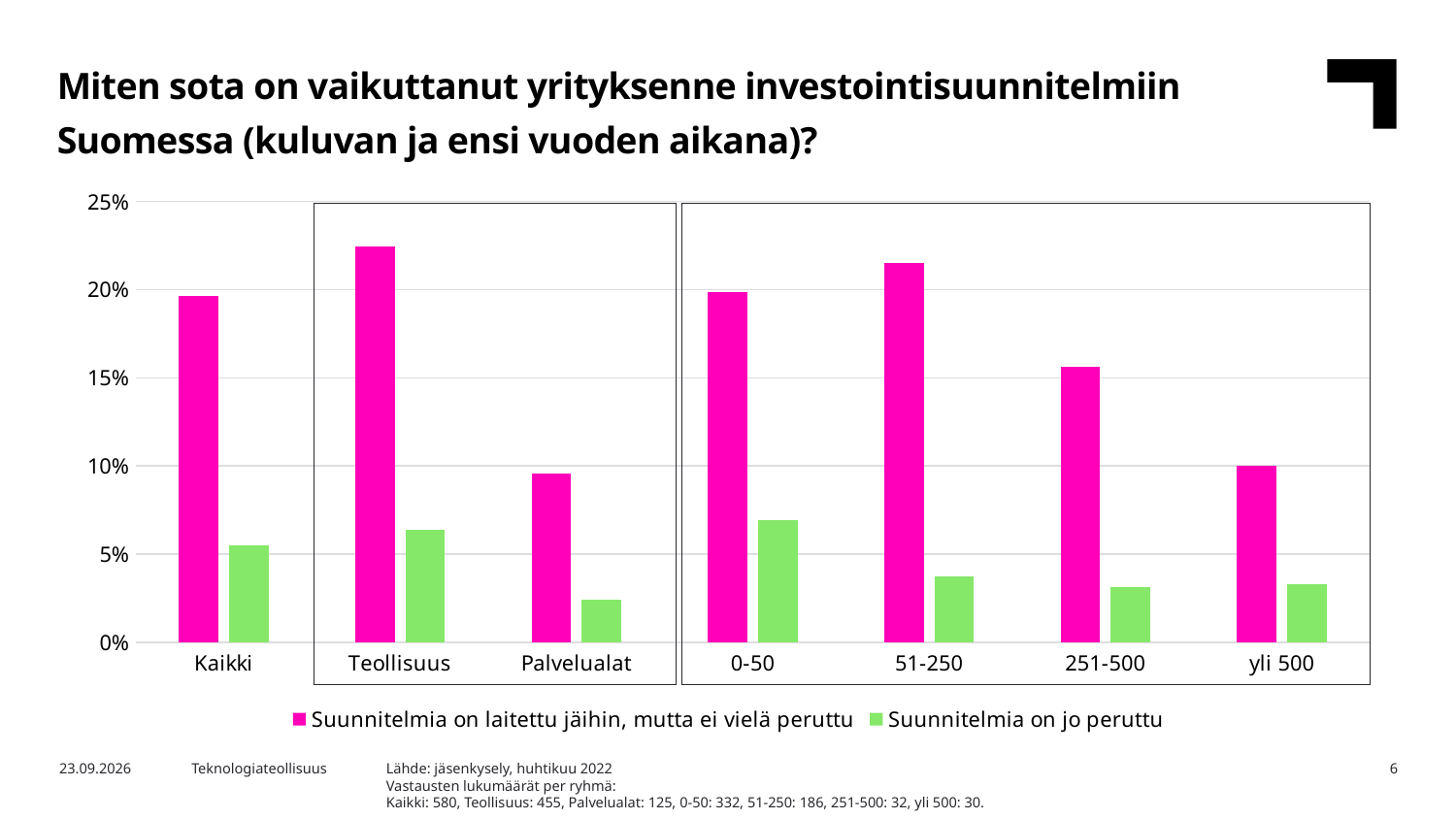
Is the value for Kaikki in the series 'Suunnitelmia on laitettu jäihin, mutta ei vielä peruttu' greater or less than 15%? greater Which is larger in the series 'Suunnitelmia on laitettu jäihin, mutta ei vielä peruttu': Teollisuus or Palvelualat? Teollisuus Is the value for 51-250 in the series 'Suunnitelmia on jo peruttu' greater or less than 5%? less Is the value for 0-50 in the series 'Suunnitelmia on jo peruttu' greater or less than 5%? greater How many series does the legend list? 2 What colour represents the series 'Suunnitelmia on jo peruttu' in the legend? green How many categories are shown on the x axis? 7 Which is larger in the series 'Suunnitelmia on laitettu jäihin, mutta ei vielä peruttu': Kaikki or 251-500? Kaikki What kind of chart is shown on the slide? bar chart